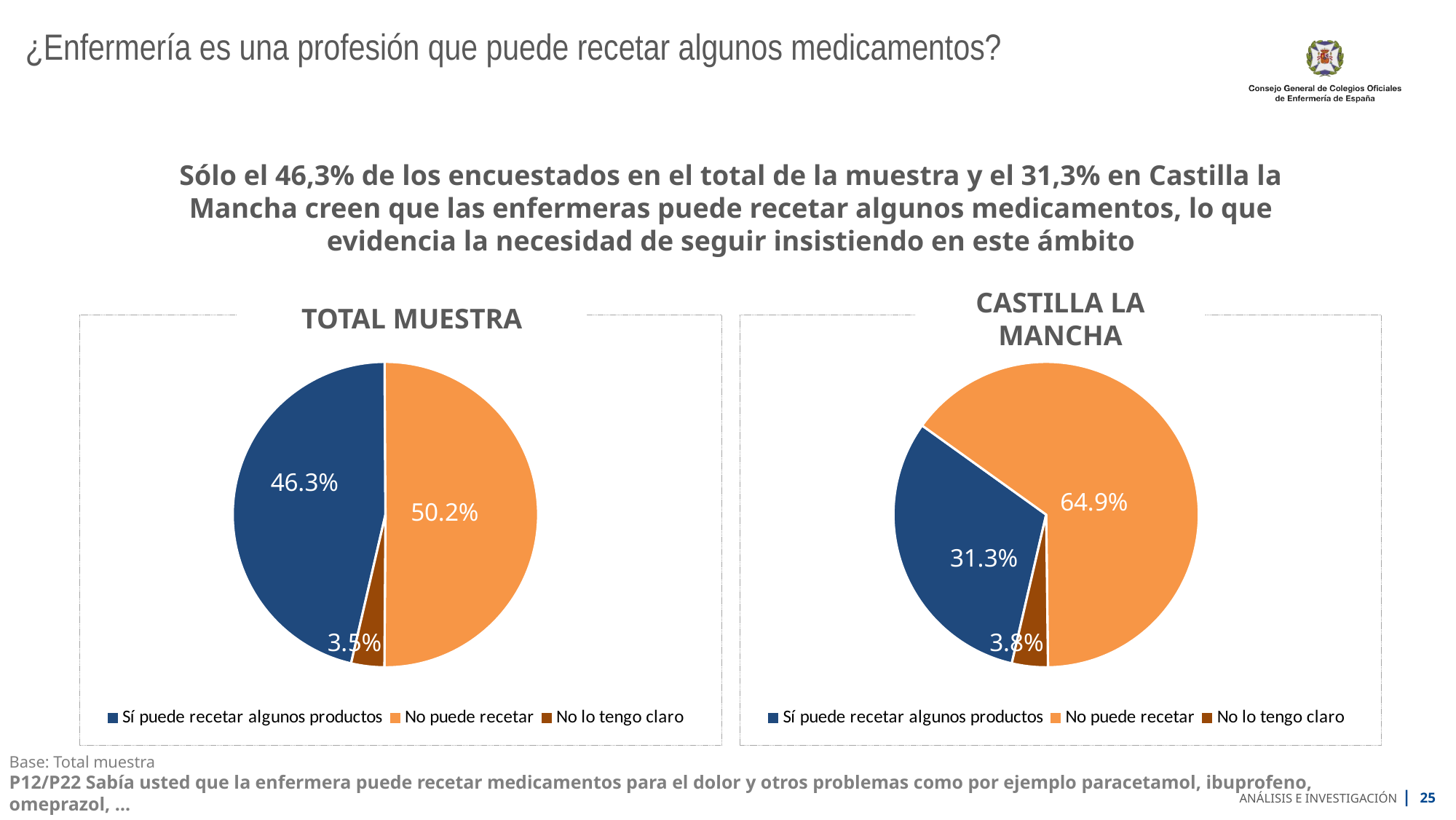
In the CASTILLA LA MANCHA chart, what percentage corresponds to 'No lo tengo claro'? 3.8% In the CASTILLA LA MANCHA chart, what percentage corresponds to 'No puede recetar'? 64.9% Which is larger in the TOTAL MUESTRA chart: 'Sí puede recetar algunos productos' or 'No puede recetar'? No puede recetar In the TOTAL MUESTRA chart, which category has the smallest slice? No lo tengo claro What kind of chart is the CASTILLA LA MANCHA chart? Pie chart In the TOTAL MUESTRA chart, what colour is the 'No lo tengo claro' slice? Dark brown In the CASTILLA LA MANCHA chart, which category has the largest slice? No puede recetar In the TOTAL MUESTRA chart, what percentage corresponds to 'No puede recetar'? 50.2% What is the difference between 'Sí puede recetar algunos productos' in the TOTAL MUESTRA chart and in the CASTILLA LA MANCHA chart? 15.0% In the TOTAL MUESTRA chart, what percentage corresponds to 'Sí puede recetar algunos productos'? 46.3% What is the difference between 'No puede recetar' and 'Sí puede recetar algunos productos' in the CASTILLA LA MANCHA chart? 33.6% How many categories does the legend of the TOTAL MUESTRA chart list? 3